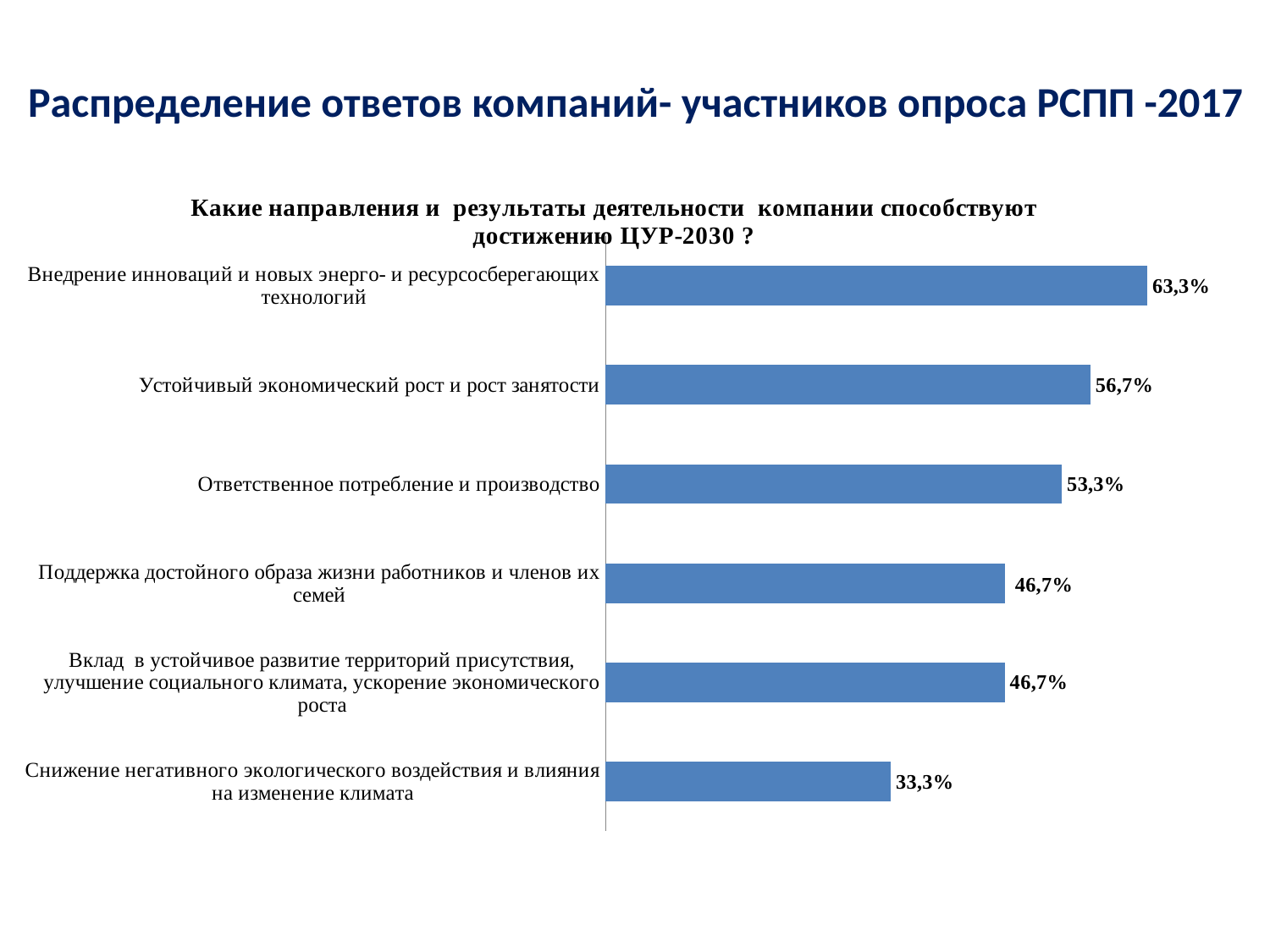
What is the difference between "Устойчивый экономический рост и рост занятости" and "Ответственное потребление и производство"? 3,4% What value is shown for "Внедрение инноваций и новых энерго- и ресурсосберегающих технологий"? 63,3% What value is shown for "Снижение негативного экологического воздействия и влияния на изменение климата"? 33,3% What kind of chart is shown on the slide? Bar chart What value is shown for "Поддержка достойного образа жизни работников и членов их семей"? 46,7% What value is shown for "Ответственное потребление и производство"? 53,3% Which category has the lowest value? Снижение негативного экологического воздействия и влияния на изменение климата What is the difference between the highest and lowest values in the chart? 30,0% Which category has the highest value? Внедрение инноваций и новых энерго- и ресурсосберегающих технологий What value is shown for "Устойчивый экономический рост и рост занятости"? 56,7% Which is larger: the value for "Ответственное потребление и производство" or for "Поддержка достойного образа жизни работников и членов их семей"? Ответственное потребление и производство How many categories are shown in the chart? 6